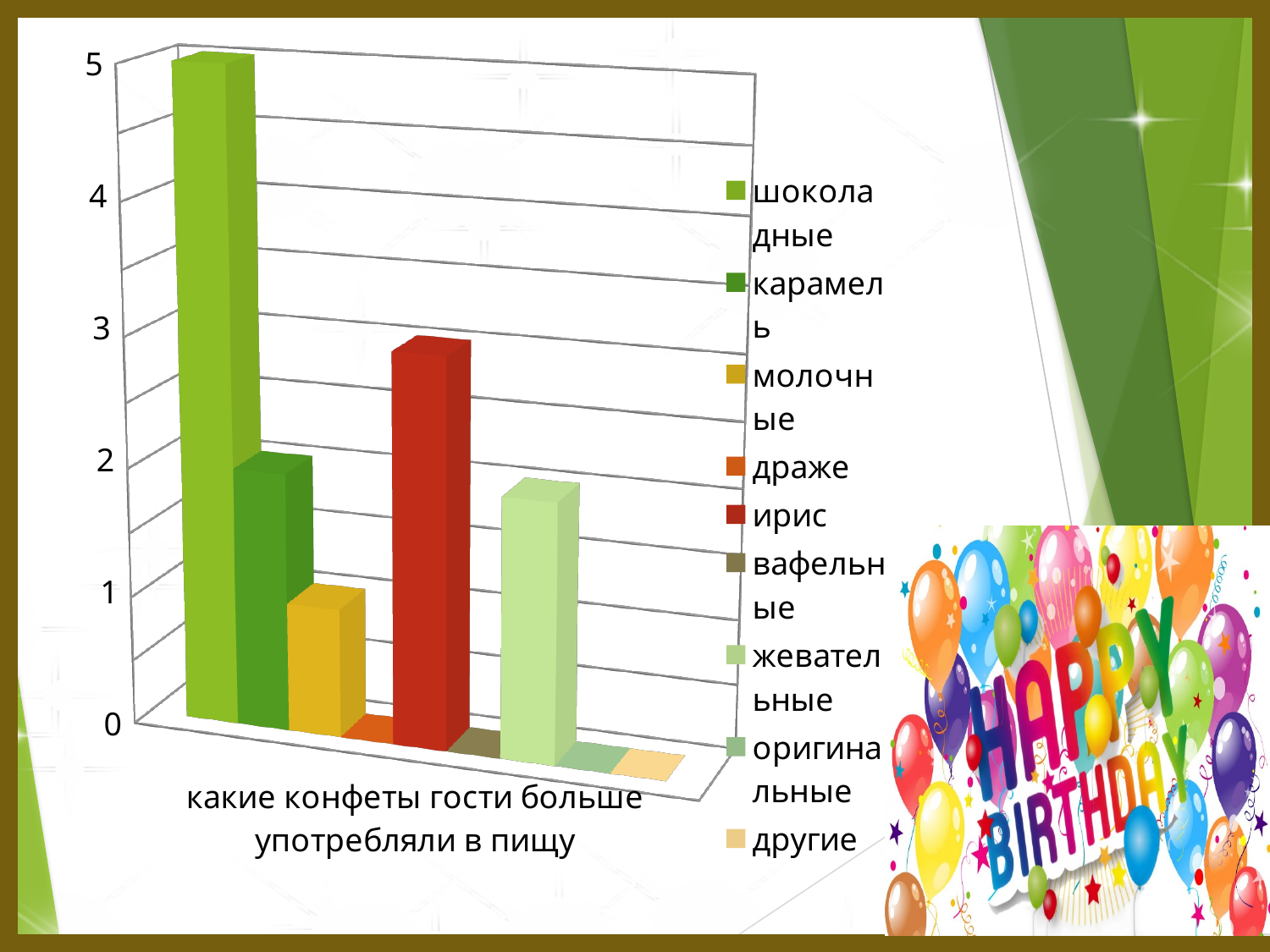
Which is larger, the value for карамель or the value for молочные? карамель Is the value for карамель greater or less than 3? less How many series does the legend list? 9 Is the value for шоколадные greater or less than 4? greater Which is larger, the value for шоколадные or the value for ирис? шоколадные Which is larger, the value for ирис or the value for жевательные? ирис What label is shown under the bars on the category axis? какие конфеты гости больше употребляли в пищу Is the value for ирис greater or less than 2? greater Which candy type has the highest bar? шоколадные What kind of chart is shown on the slide? bar chart